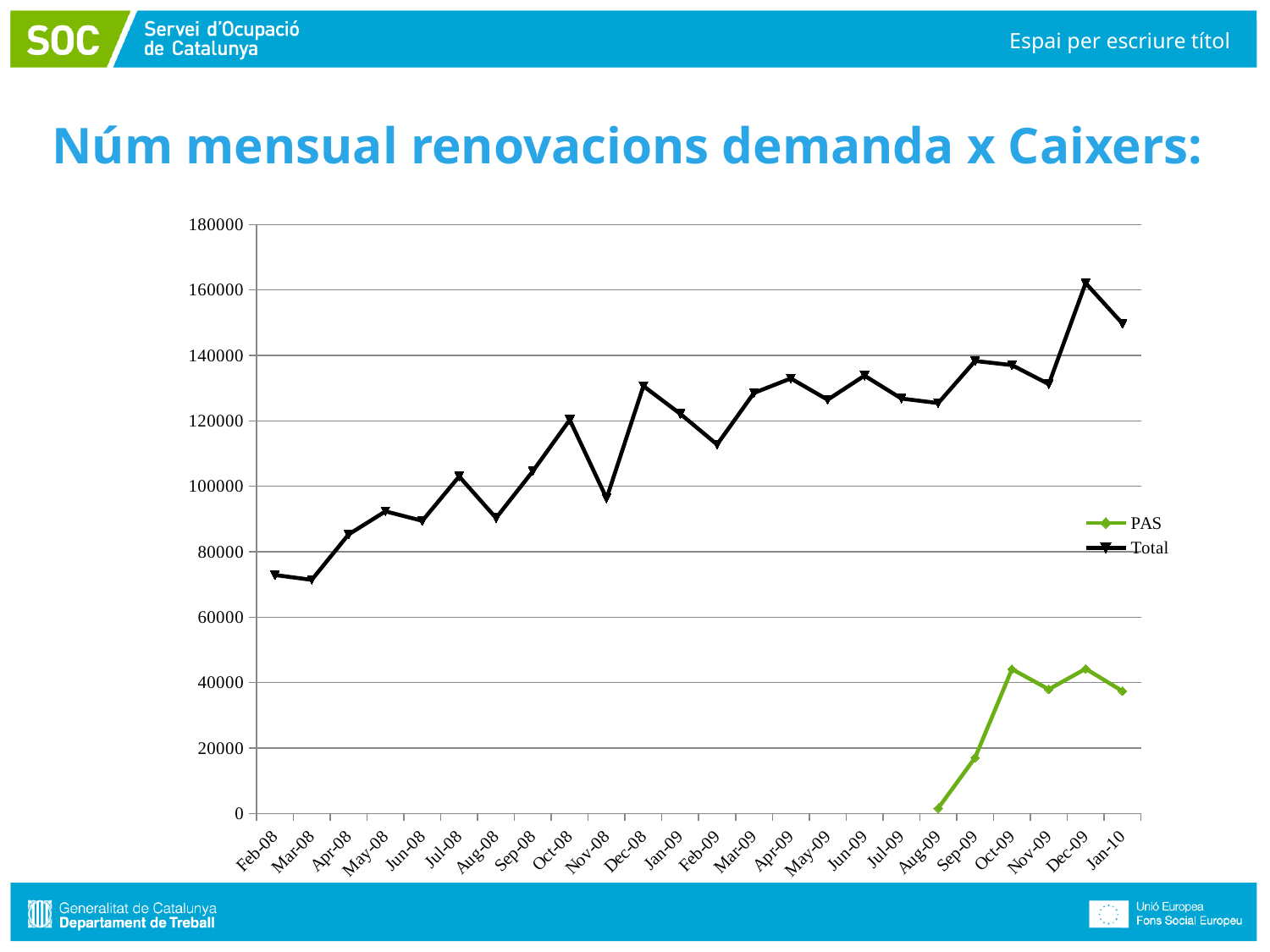
What are the names of the series in the legend? PAS and Total Which is larger, the Total value for Nov-08 or for Dec-08? Dec-08 How many months are plotted along the x axis? 24 Is the Total value for Feb-08 greater or less than 80000? less Is the PAS value for Oct-09 greater or less than 40000? greater In which month does the Total series have its lowest value? Mar-08 What kind of chart is shown on the slide? Line chart Is the Total value for Dec-08 greater or less than 120000? greater In which month does the Total series reach its highest value? Dec-09 Does the Total series generally rise or fall from Feb-08 to Jan-10? rise How many series does the legend list? 2 In which month does the PAS series have its lowest value? Aug-09